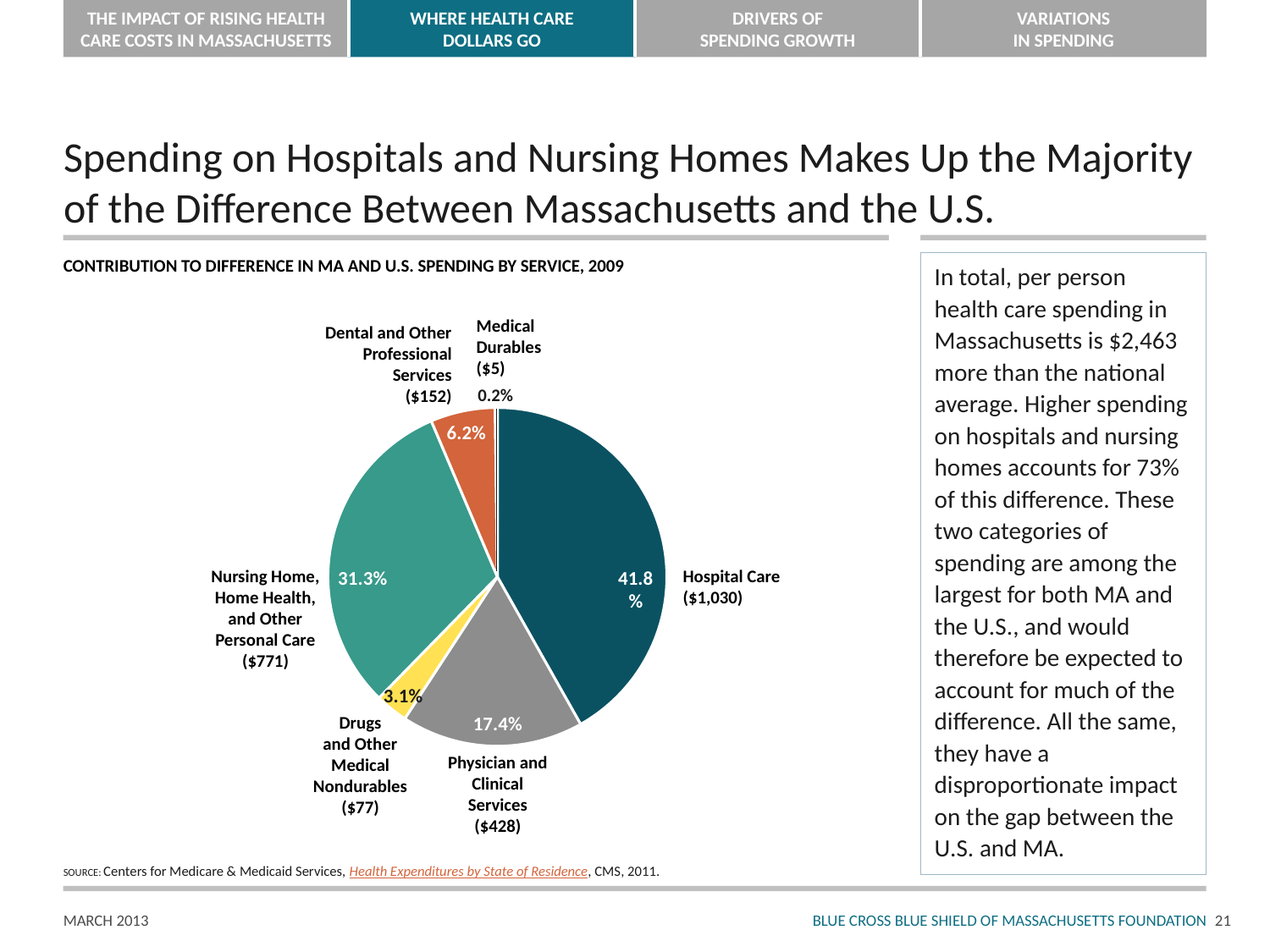
What type of chart is shown on the slide? Pie chart What is the difference in dollars between Hospital Care and Physician and Clinical Services? $602 Which category has the largest slice of the pie? Hospital Care What dollar amount is shown for Medical Durables? $5 Which category has the smallest slice of the pie? Medical Durables What is the title of the chart? Contribution to Difference in MA and U.S. Spending by Service, 2009 How many categories are shown in the pie chart? 6 Which is larger: the share for Dental and Other Professional Services or the share for Drugs and Other Medical Nondurables? Dental and Other Professional Services What share of the pie does Hospital Care represent? 41.8% What dollar amount is shown for Nursing Home, Home Health, and Other Personal Care? $771 What is the combined percentage share of Hospital Care and Nursing Home, Home Health, and Other Personal Care? 73.1% What percentage of the pie is Physician and Clinical Services? 17.4%